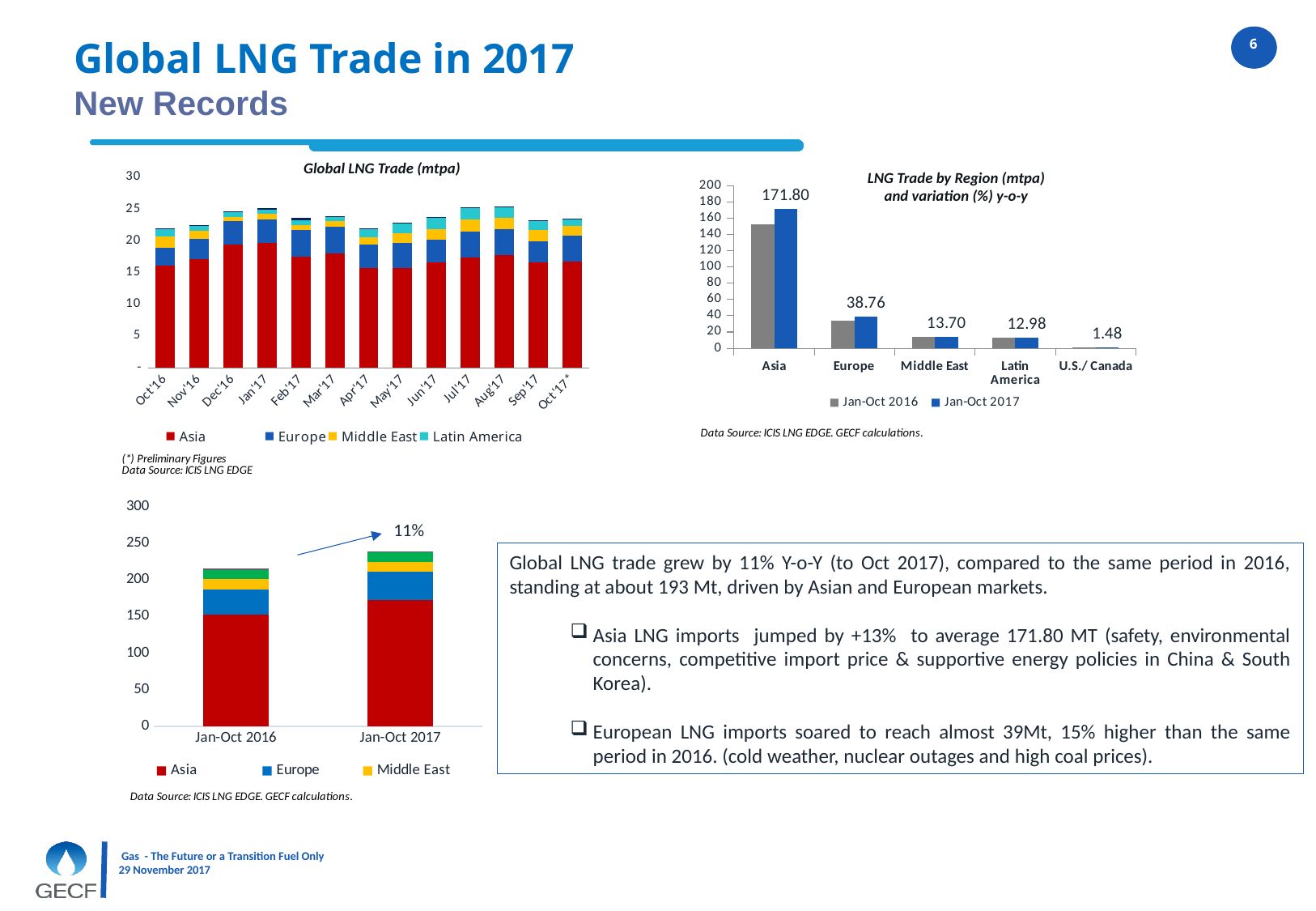
In the 'LNG Trade by Region (mtpa)' chart, what is the Jan-Oct 2017 value for Asia? 171.80 In the 'LNG Trade by Region (mtpa)' chart, what is the Jan-Oct 2017 value for Europe? 38.76 In the 'LNG Trade by Region (mtpa)' chart, is the Jan-Oct 2016 value for Asia greater or less than 140? greater How many months are shown on the x axis of the 'Global LNG Trade (mtpa)' chart? 13 How many series does the legend of the 'LNG Trade by Region (mtpa)' chart list? 2 In the 'LNG Trade by Region (mtpa)' chart, which region has the highest Jan-Oct 2017 value? Asia How many regions are shown in the 'LNG Trade by Region (mtpa)' chart? 5 In the 'LNG Trade by Region (mtpa)' chart, which region has the lowest Jan-Oct 2017 value? U.S./ Canada What kind of chart is the bottom-left chart comparing Jan-Oct 2016 and Jan-Oct 2017? Stacked bar chart How many series does the legend of the 'Global LNG Trade (mtpa)' chart list? 4 In the 'LNG Trade by Region (mtpa)' chart, what is the Jan-Oct 2017 value for U.S./Canada? 1.48 In the 'LNG Trade by Region (mtpa)' chart, what is the difference between the Jan-Oct 2017 values for Middle East and Latin America? 0.72